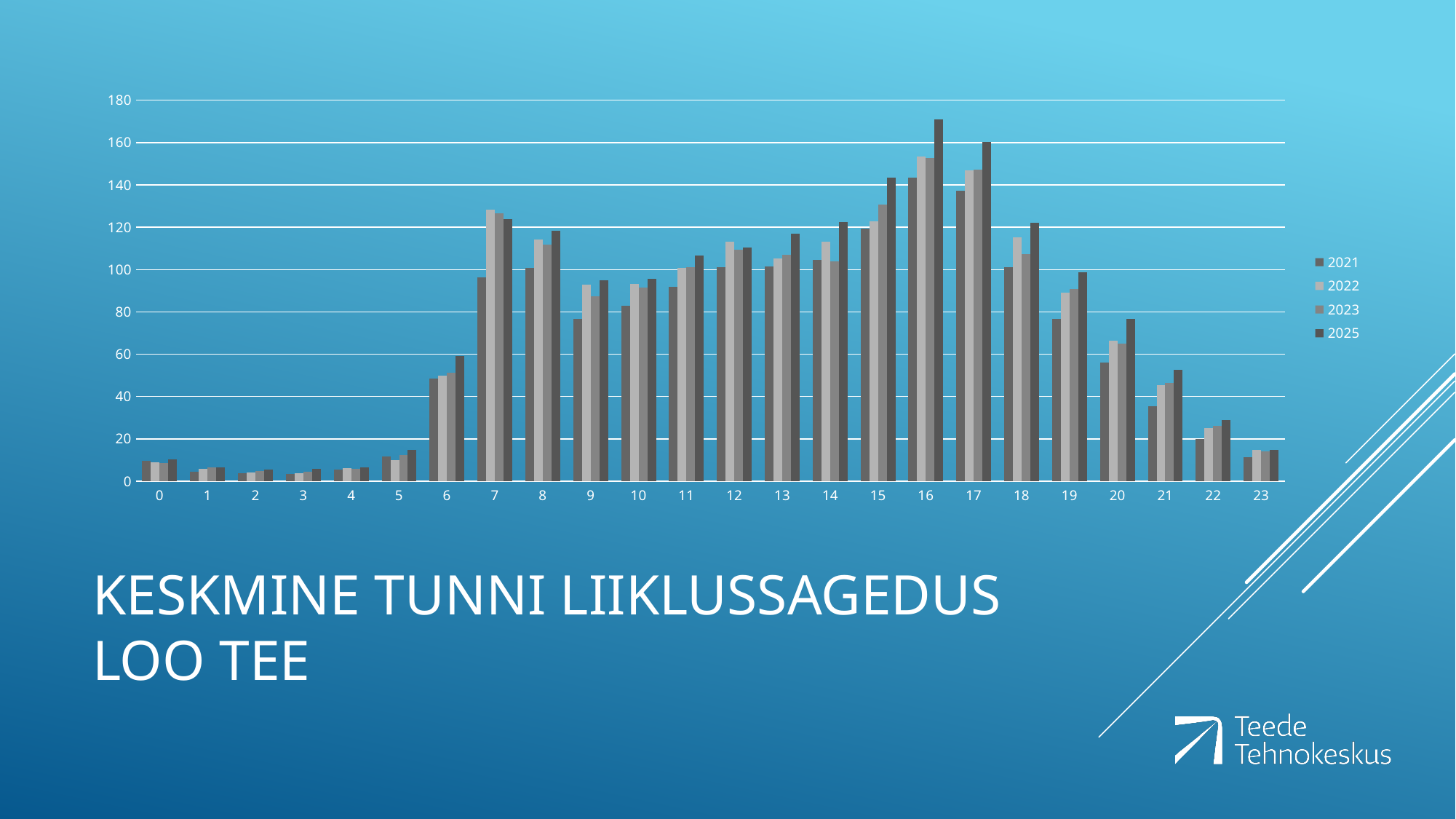
How many categories (hours) are shown on the x axis? 24 At hour 7, which series has the larger value, 2021 or 2022? 2022 What kind of chart is shown on the slide? bar chart Is the 2023 value at hour 18 greater or less than 100? greater Is the 2022 value at hour 7 greater or less than 120? greater At which hour does the 2025 series reach its highest value? 16 What is the title of the slide containing the chart? KESKMINE TUNNI LIIKLUSSAGEDUS LOO TEE Is the 2021 value at hour 21 greater or less than 40? less Do the 2025 values rise or fall from hour 17 to hour 23? fall How many series does the legend list? 4 Which year is not included in the legend between 2021 and 2025? 2024